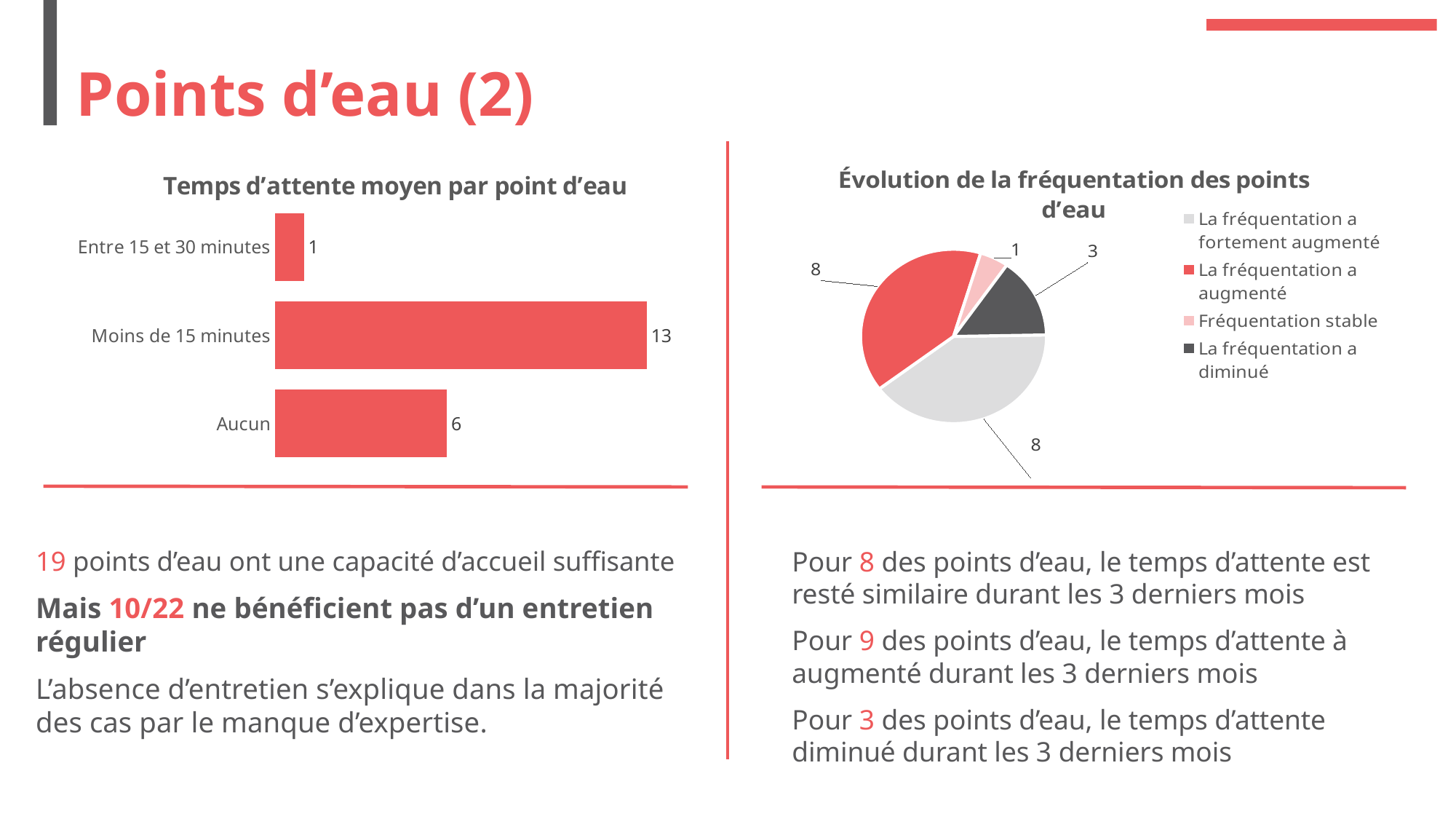
In the pie chart 'Évolution de la fréquentation des points d'eau', what share of the total does 'La fréquentation a diminué' represent? 15% What kind of chart is 'Temps d'attente moyen par point d'eau'? Bar chart In the chart 'Temps d'attente moyen par point d'eau', which category has the lowest value? Entre 15 et 30 minutes In the chart 'Temps d'attente moyen par point d'eau', which category has the highest value? Moins de 15 minutes In the pie chart 'Évolution de la fréquentation des points d'eau', which is larger: 'La fréquentation a augmenté' or 'Fréquentation stable'? La fréquentation a augmenté In the chart 'Temps d'attente moyen par point d'eau', what is the value for 'Moins de 15 minutes'? 13 How many entries does the legend of the pie chart 'Évolution de la fréquentation des points d'eau' list? 4 In the pie chart 'Évolution de la fréquentation des points d'eau', what is the value for 'La fréquentation a diminué'? 3 In the chart 'Temps d'attente moyen par point d'eau', what is the difference between 'Moins de 15 minutes' and 'Aucun'? 7 In the chart 'Temps d'attente moyen par point d'eau', what is the value for 'Aucun'? 6 In the pie chart 'Évolution de la fréquentation des points d'eau', what is the value for 'Fréquentation stable'? 1 How many categories are shown in the chart 'Temps d'attente moyen par point d'eau'? 3